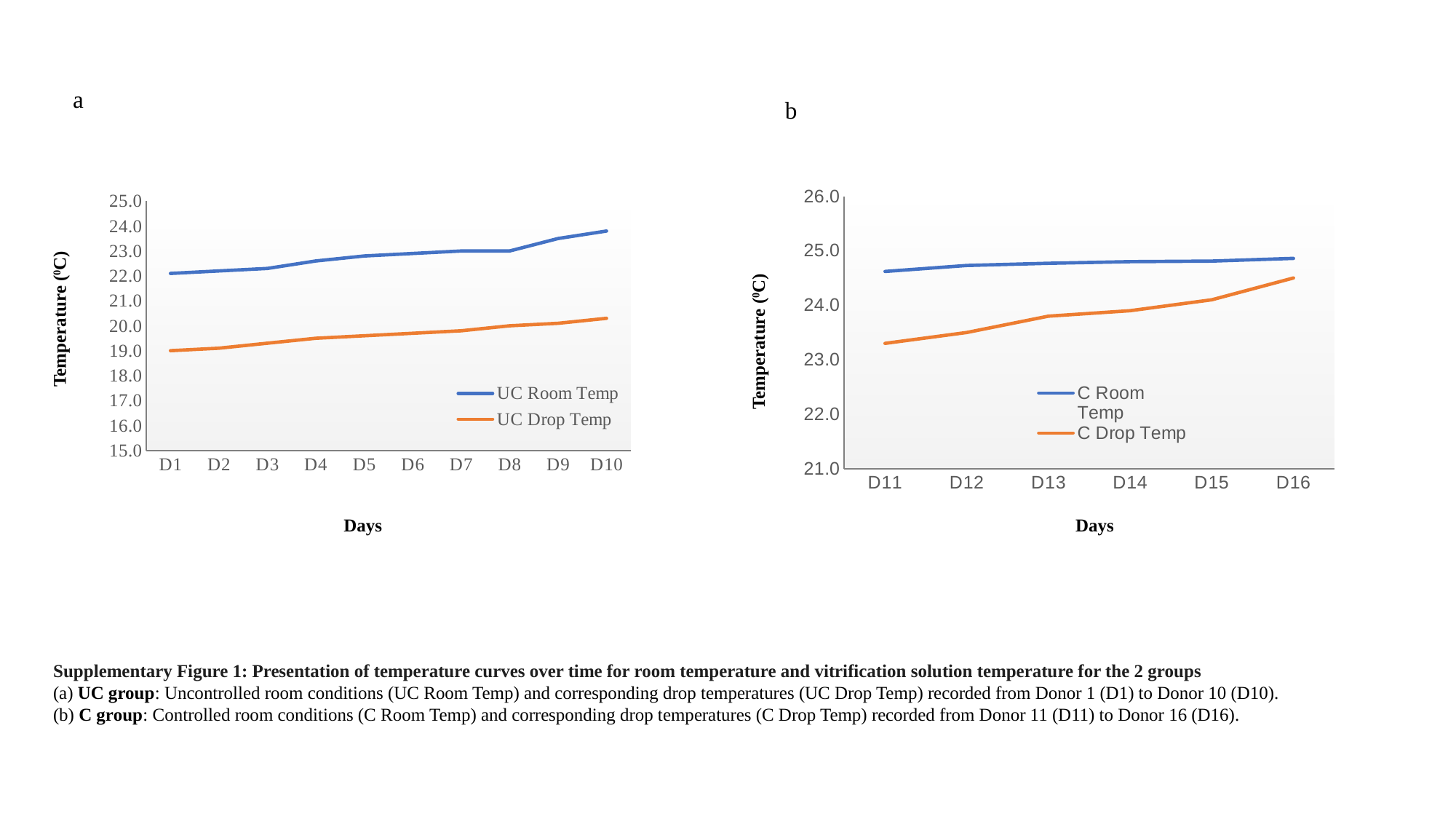
In chart b (the right chart), on which day is C Drop Temp lowest? D11 How many days (categories) are shown on the x axis of chart b (the right chart)? 6 In chart a (the left chart), on which day is UC Room Temp highest? D10 In chart a (the left chart), does the UC Drop Temp line rise or fall from D1 to D10? rise How many days (categories) are shown on the x axis of chart a (the left chart)? 10 What is the y-axis title of chart b (the right chart)? Temperature (⁰C) In chart a (the left chart), is the UC Room Temp value at D10 greater or less than 23.0? greater In chart a (the left chart), which series has the larger value at D5, UC Room Temp or UC Drop Temp? UC Room Temp What kind of chart is chart a (the left chart)? line chart In chart b (the right chart), is the C Room Temp value at D16 greater or less than 25.0? less In chart b (the right chart), does the C Drop Temp line rise or fall from D11 to D16? rise How many series does the legend of chart b (the right chart) list? 2